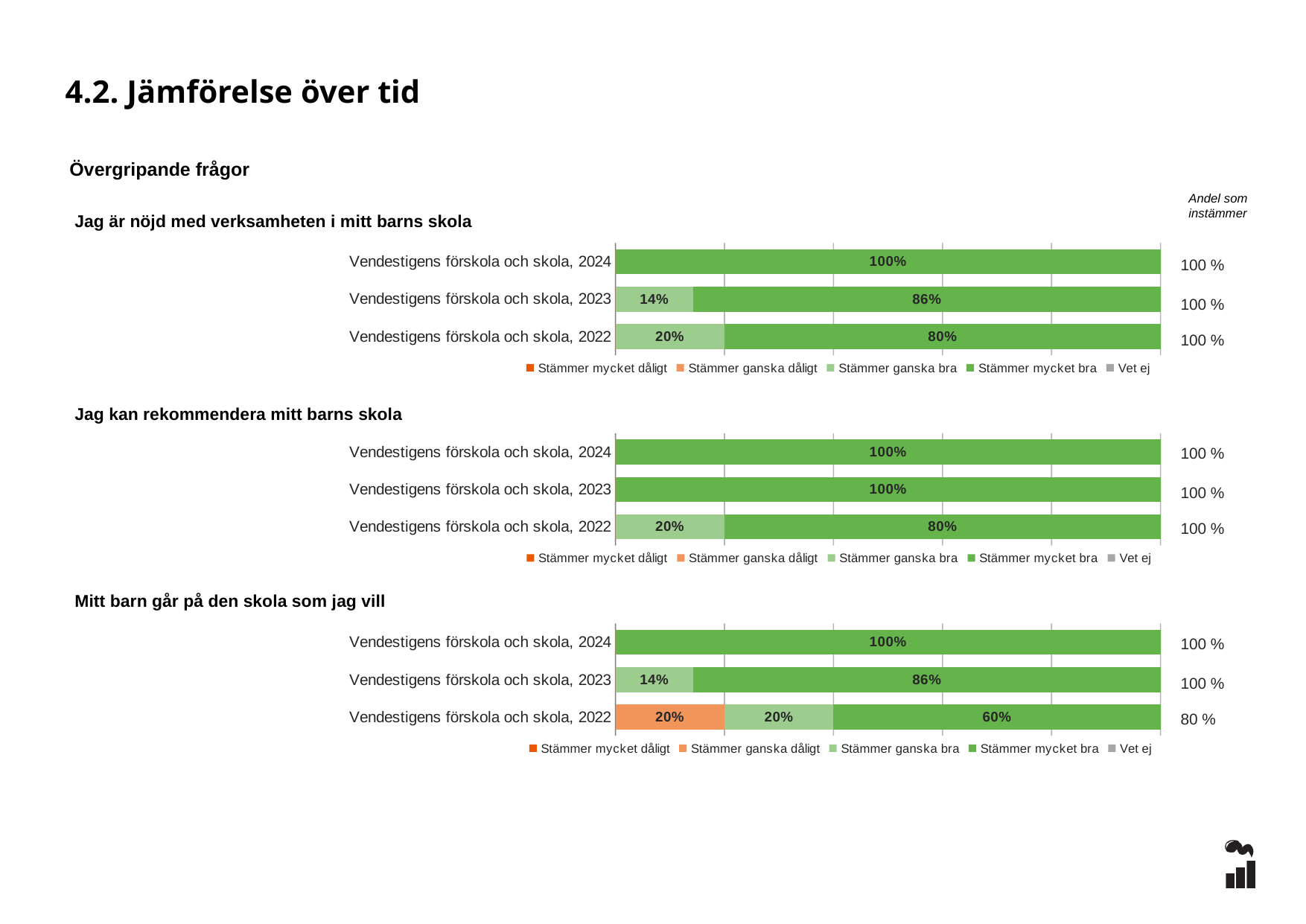
In the chart 'Jag är nöjd med verksamheten i mitt barns skola', what is the difference between the 'Stämmer mycket bra' values for 2023 and 2022? 6% In the chart 'Mitt barn går på den skola som jag vill', which is larger: the 'Stämmer mycket bra' value for 2023 or for 2022? 2023 In the chart 'Mitt barn går på den skola som jag vill', what is the total of the stacked bar for Vendestigens förskola och skola, 2022? 100% In the chart 'Jag är nöjd med verksamheten i mitt barns skola', what is the 'Stämmer mycket bra' value for Vendestigens förskola och skola, 2023? 86% How many bars (categories) are shown in the chart 'Jag är nöjd med verksamheten i mitt barns skola'? 3 In the chart 'Jag kan rekommendera mitt barns skola', what is the 'Stämmer mycket bra' value for Vendestigens förskola och skola, 2022? 80% In the chart 'Mitt barn går på den skola som jag vill', what is the 'Andel som instämmer' value for Vendestigens förskola och skola, 2022? 80 % In the chart 'Mitt barn går på den skola som jag vill', which year has the lowest 'Stämmer mycket bra' value? Vendestigens förskola och skola, 2022 In the chart 'Jag är nöjd med verksamheten i mitt barns skola', what is the 'Stämmer ganska bra' value for Vendestigens förskola och skola, 2022? 20% In the chart 'Mitt barn går på den skola som jag vill', what is the 'Stämmer ganska dåligt' value for Vendestigens förskola och skola, 2022? 20% How many series does the legend of the chart 'Jag kan rekommendera mitt barns skola' list? 5 What kind of chart is 'Mitt barn går på den skola som jag vill'? Stacked bar chart